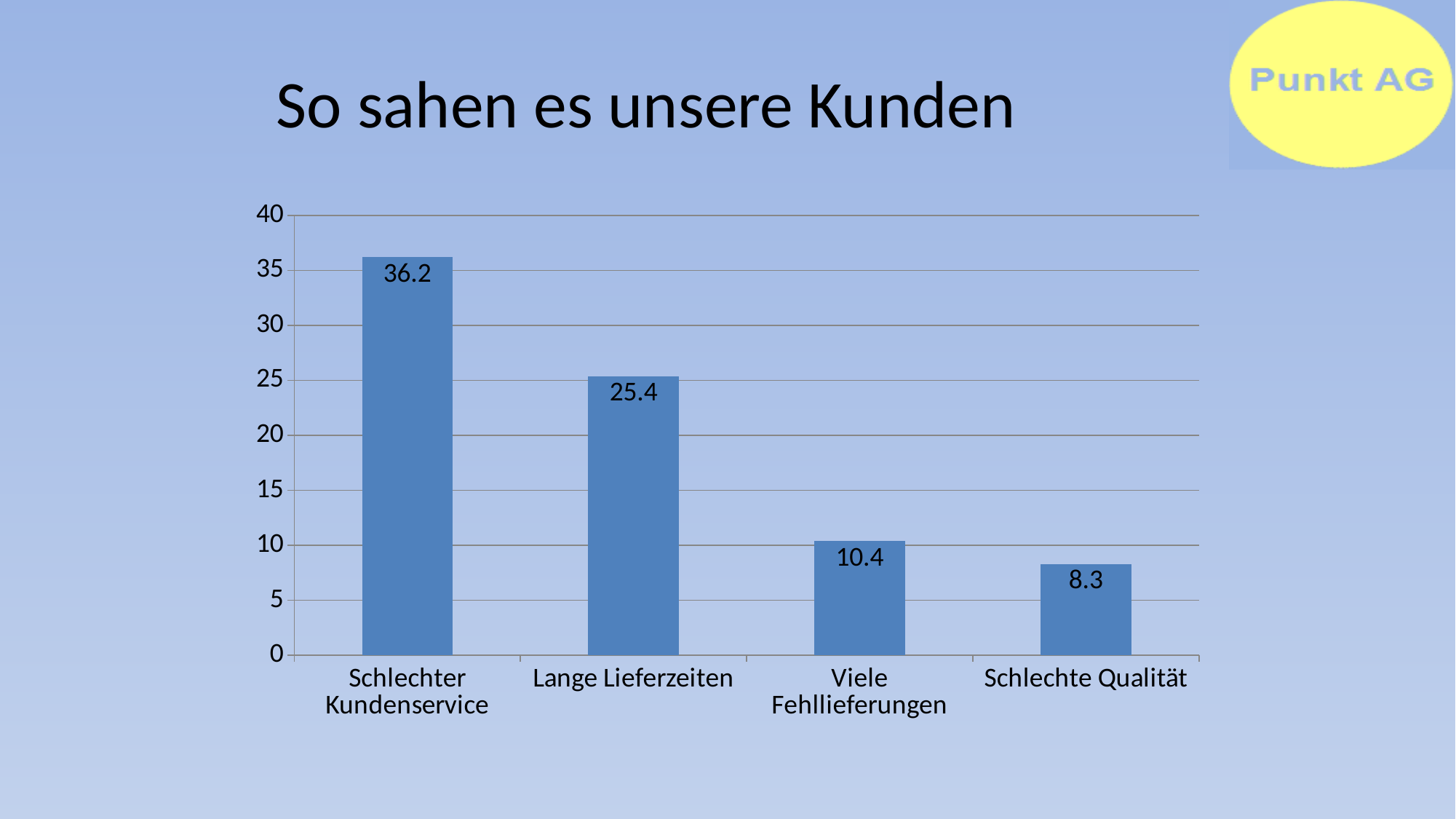
What is the difference between the values for Viele Fehllieferungen and Schlechte Qualität? 2.1 What is the value for Viele Fehllieferungen? 10.4 What is the difference between the values for Schlechter Kundenservice and Lange Lieferzeiten? 10.8 Do the values rise or fall from left to right along the x axis? Fall Which category has the lowest value? Schlechte Qualität What kind of chart is shown on the slide? Bar chart What is the value for Schlechter Kundenservice? 36.2 What is the value for Lange Lieferzeiten? 25.4 Which category has the highest value? Schlechter Kundenservice How many categories are shown in the chart? 4 Which is larger, the value for Lange Lieferzeiten or the value for Viele Fehllieferungen? Lange Lieferzeiten What is the value for Schlechte Qualität? 8.3